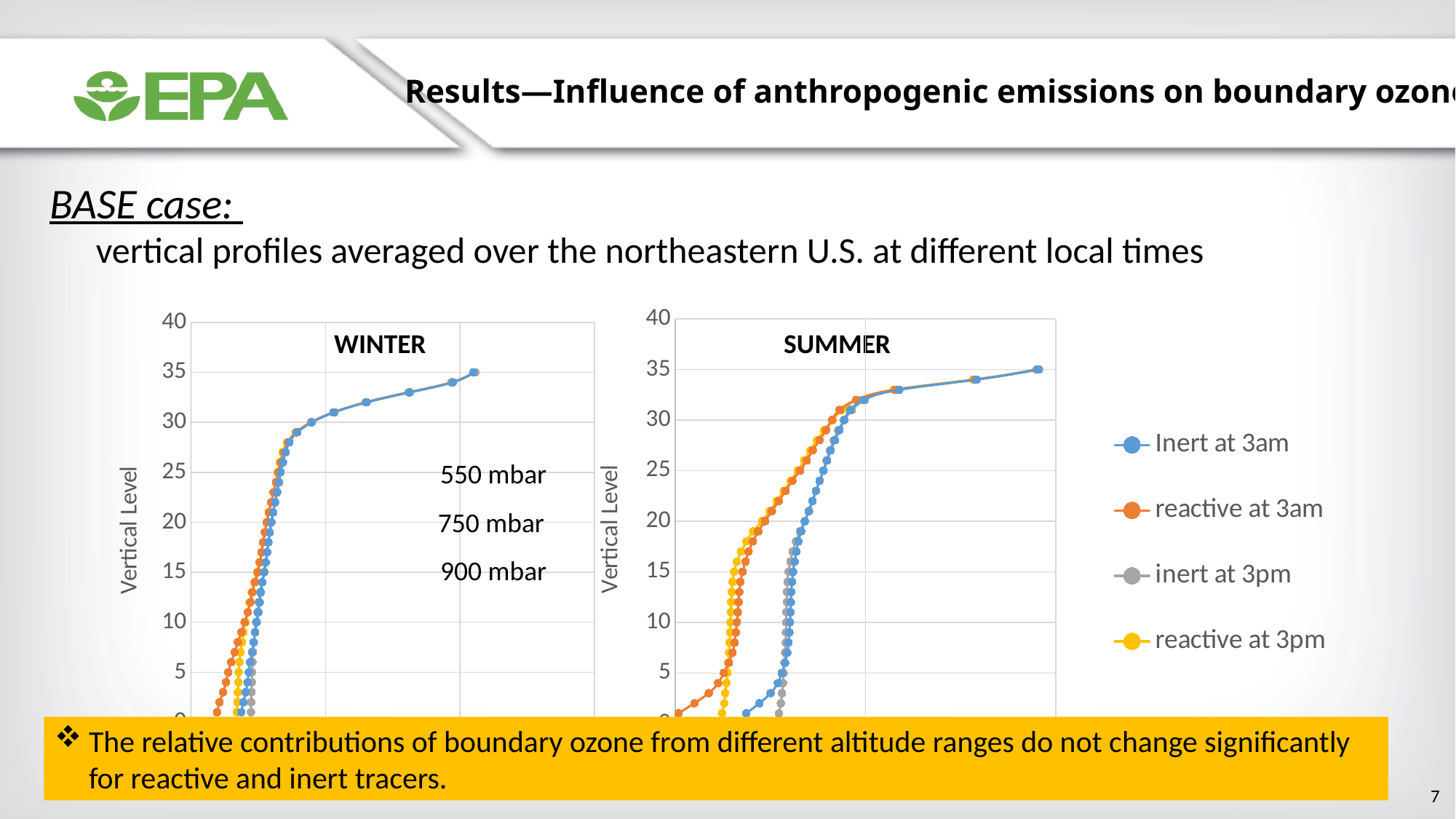
Which legend entry is shown in orange? reactive at 3am In the WINTER chart, at vertical level 5, which series has the larger horizontal value: inert at 3pm or reactive at 3am? inert at 3pm What is the label of the vertical axis on the SUMMER chart? Vertical Level In the SUMMER chart, at vertical level 20, which series has the smaller horizontal value: reactive at 3am or Inert at 3am? reactive at 3am In the SUMMER chart, at vertical level 10, which series has the larger horizontal value: Inert at 3am or reactive at 3pm? Inert at 3am What is the highest tick value on the vertical axis of the WINTER chart? 40 What is the highest vertical level reached by the plotted points in the SUMMER chart? 35 How many series does the legend list? 4 In the WINTER chart, does the horizontal value of the Inert at 3am series increase or decrease as the vertical level rises from 30 to 35? increase What kind of chart is the WINTER chart? line chart How many charts are shown on the slide? 2